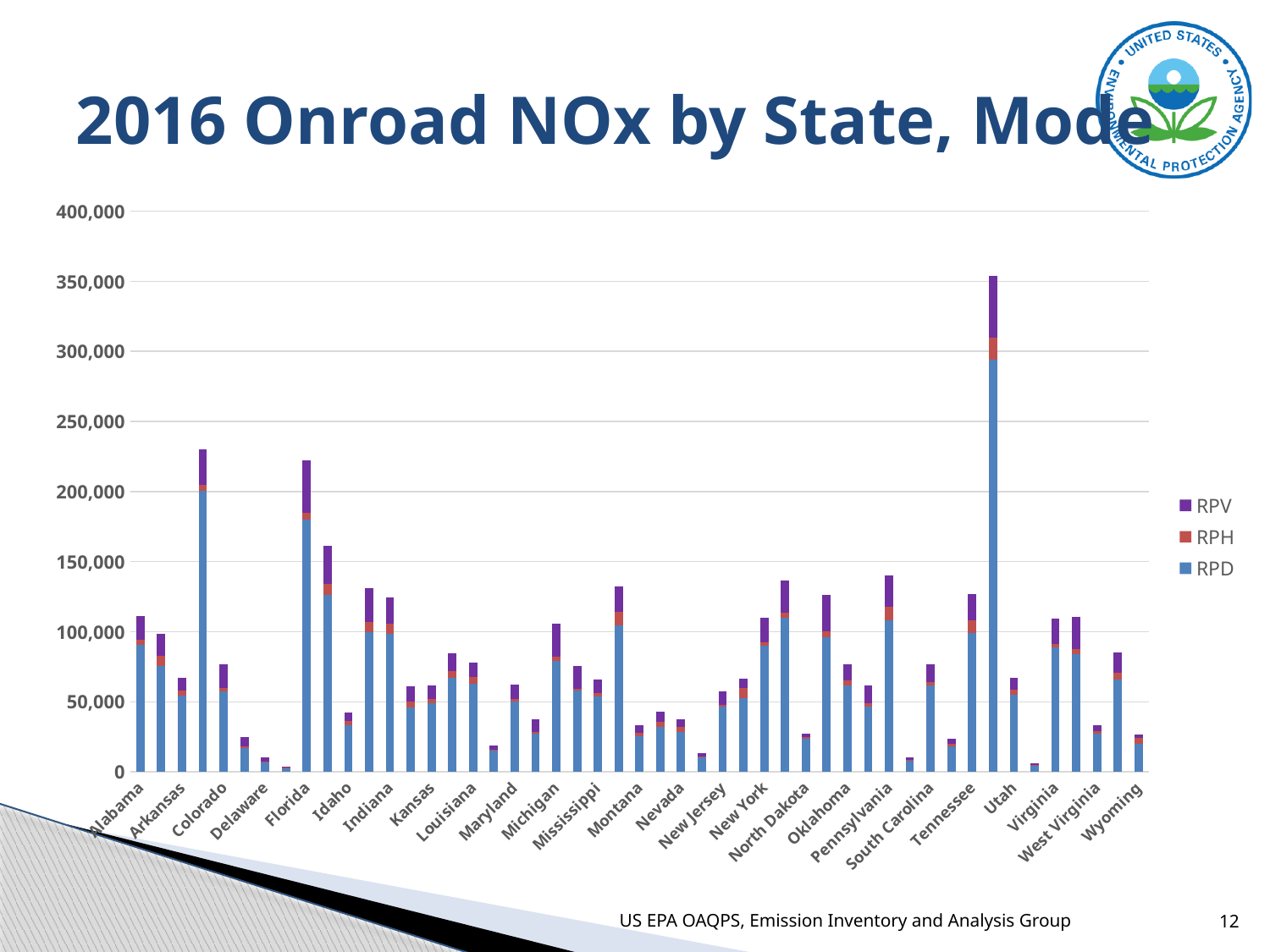
What are the three series named in the legend? RPV, RPH, RPD What kind of chart is shown on the slide? stacked bar chart Which has the larger total, Michigan or Delaware? Michigan Is the total value for Pennsylvania greater or less than 100,000? greater What is the title of the chart? 2016 Onroad NOx by State, Mode How many series does the legend list? 3 Is the total value for Tennessee greater or less than 100,000? greater Is the total value for Florida greater or less than 200,000? greater Which has the larger total, Idaho or Indiana? Indiana Which has the larger total, Florida or Alabama? Florida